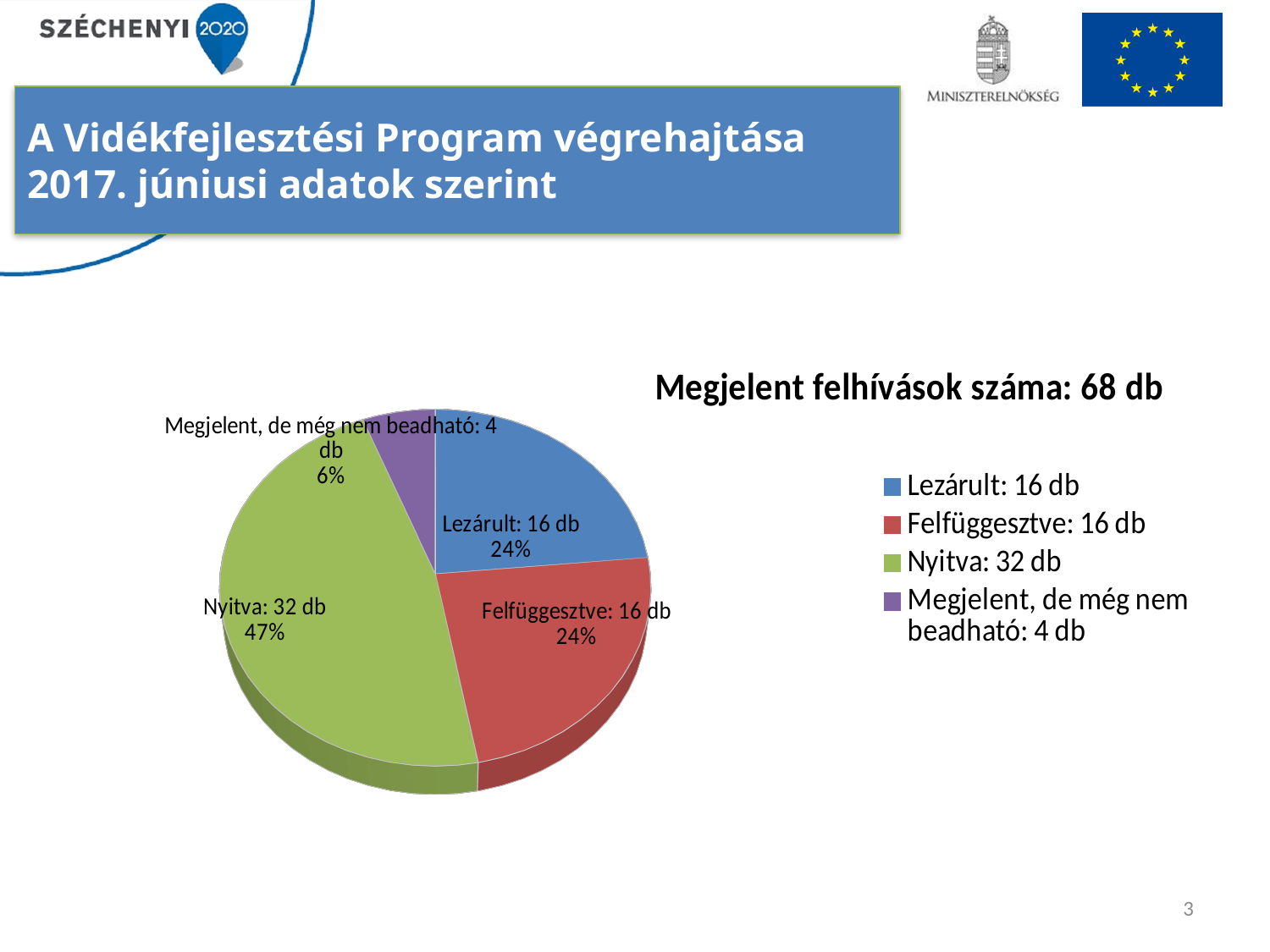
How many slices does the pie chart have? 4 What percentage share does the Lezárult slice have in the pie chart? 24% What percentage share does the 'Megjelent, de még nem beadható' slice have in the pie chart? 6% Which category has the largest slice in the pie chart? Nyitva What percentage share does the Nyitva slice have in the pie chart? 47% Which is larger, the Nyitva slice or the Felfüggesztve slice? Nyitva Which category has the smallest slice in the pie chart? Megjelent, de még nem beadható How many items (db) does the Nyitva slice represent? 32 db What kind of chart is shown on the slide? pie chart What total number of published calls (Megjelent felhívások száma) is stated next to the chart? 68 db How many items (db) does the Felfüggesztve slice represent? 16 db What is the difference in db between the Nyitva and Lezárult categories? 16 db